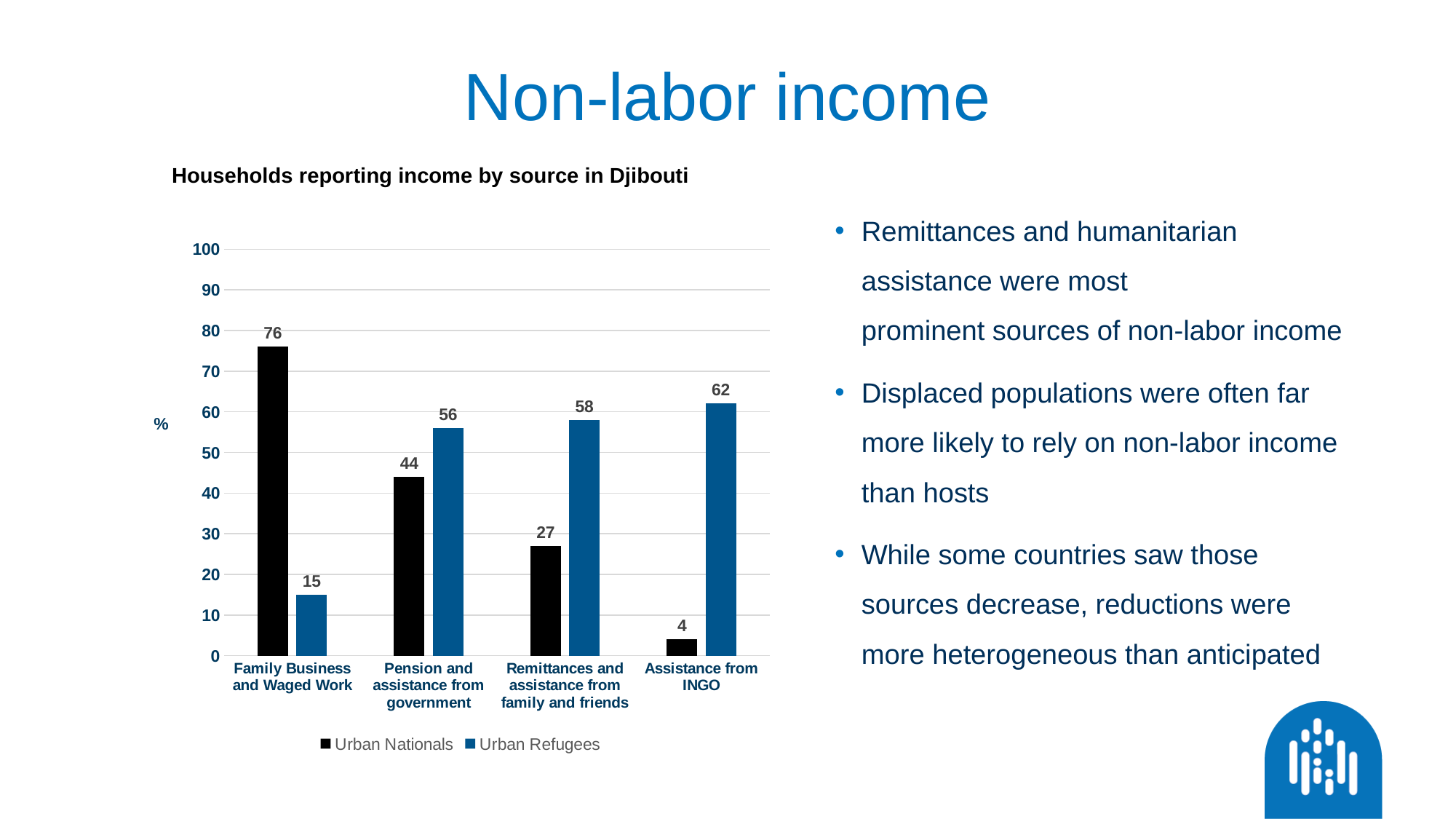
What kind of chart is shown on the slide? Bar chart Which category has the highest value for Urban Nationals? Family Business and Waged Work How many income source categories are shown on the x axis? 4 Is the value for Urban Nationals in the Pension and assistance from government category greater or less than 50? less What is the value for Urban Nationals in the Family Business and Waged Work category? 76 Which category has the lowest value for Urban Refugees? Family Business and Waged Work Which is larger in the Remittances and assistance from family and friends category: Urban Nationals or Urban Refugees? Urban Refugees What is the difference between Urban Refugees and Urban Nationals in the Assistance from INGO category? 58 What is the value for Urban Refugees in the Assistance from INGO category? 62 What is the value for Urban Refugees in the Pension and assistance from government category? 56 How many series does the legend list? 2 What is the title of the chart? Households reporting income by source in Djibouti